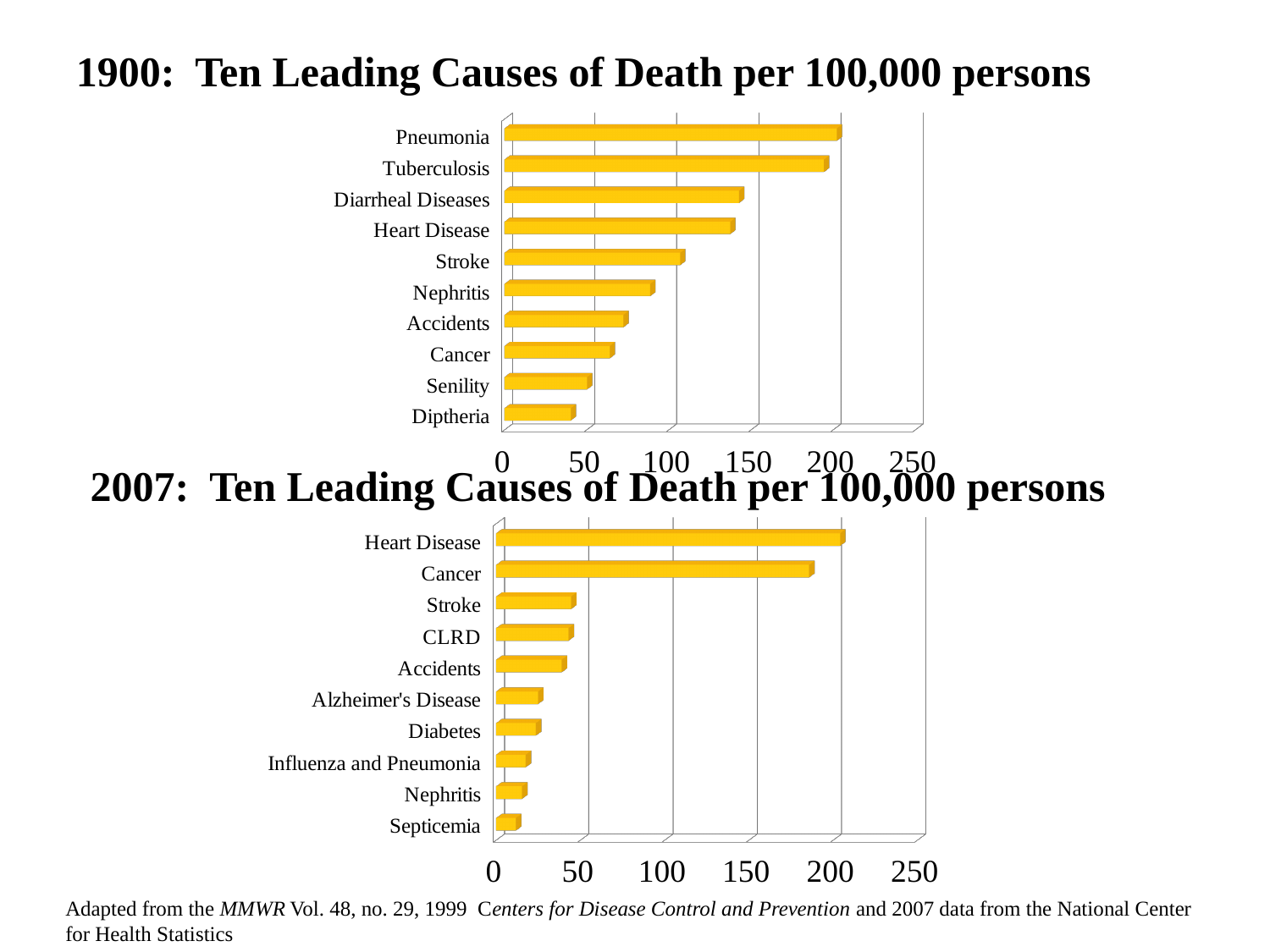
In the 1900 chart, is the value for Nephritis greater or less than 100? less In the 1900 chart, which cause of death has the highest rate? Pneumonia What is the title of the bottom chart? 2007: Ten Leading Causes of Death per 100,000 persons How many causes of death are shown in the 2007 chart? 10 In the 2007 chart, is the value for Alzheimer's Disease greater or less than 50? less In the 2007 chart, which cause of death has the highest rate? Heart Disease In the 1900 chart, which is larger, the value for Heart Disease or the value for Stroke? Heart Disease In the 2007 chart, is the value for Cancer greater or less than 200? less In the 2007 chart, which cause of death has the lowest rate? Septicemia What kind of chart is the 1900 chart? bar chart In the 1900 chart, which cause of death has the lowest rate? Diptheria